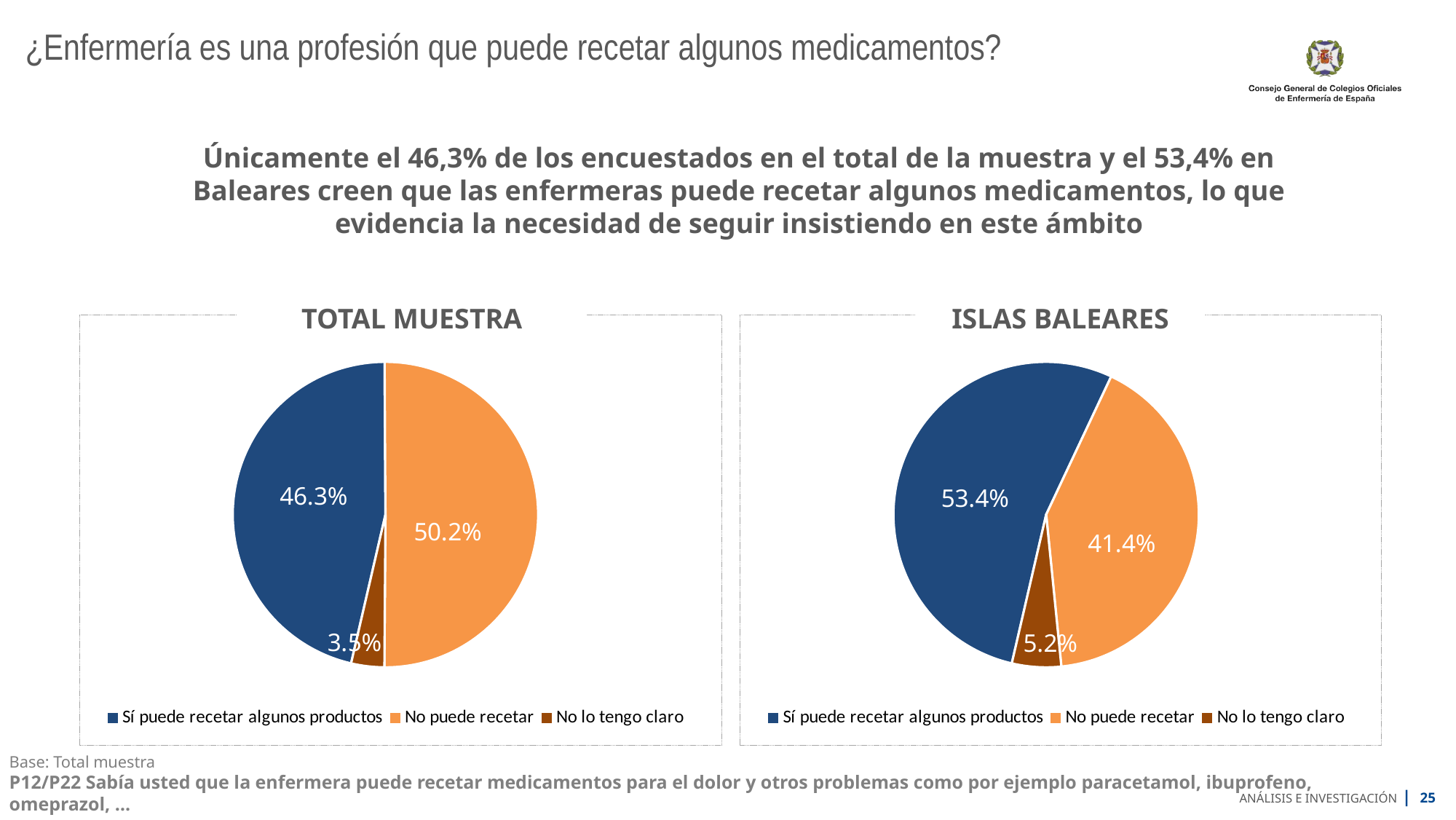
What kind of chart is the ISLAS BALEARES chart? Pie chart Which chart has the larger value for 'No lo tengo claro', TOTAL MUESTRA or ISLAS BALEARES? ISLAS BALEARES In the ISLAS BALEARES chart, what is the difference between 'Sí puede recetar algunos productos' and 'No puede recetar'? 12.0% In the ISLAS BALEARES chart, what is the value for 'No lo tengo claro'? 5.2% How many categories does the TOTAL MUESTRA chart show? 3 In the TOTAL MUESTRA chart, which category has the smallest share? No lo tengo claro In the TOTAL MUESTRA chart, what is the difference between 'No puede recetar' and 'Sí puede recetar algunos productos'? 3.9% In the ISLAS BALEARES chart, what is the value for 'No puede recetar'? 41.4% In the TOTAL MUESTRA chart, what is the value for 'Sí puede recetar algunos productos'? 46.3% In the TOTAL MUESTRA chart, what is the value for 'No puede recetar'? 50.2% In the ISLAS BALEARES chart, which category has the largest share? Sí puede recetar algunos productos In the TOTAL MUESTRA chart, what colour is the 'No puede recetar' slice? Orange